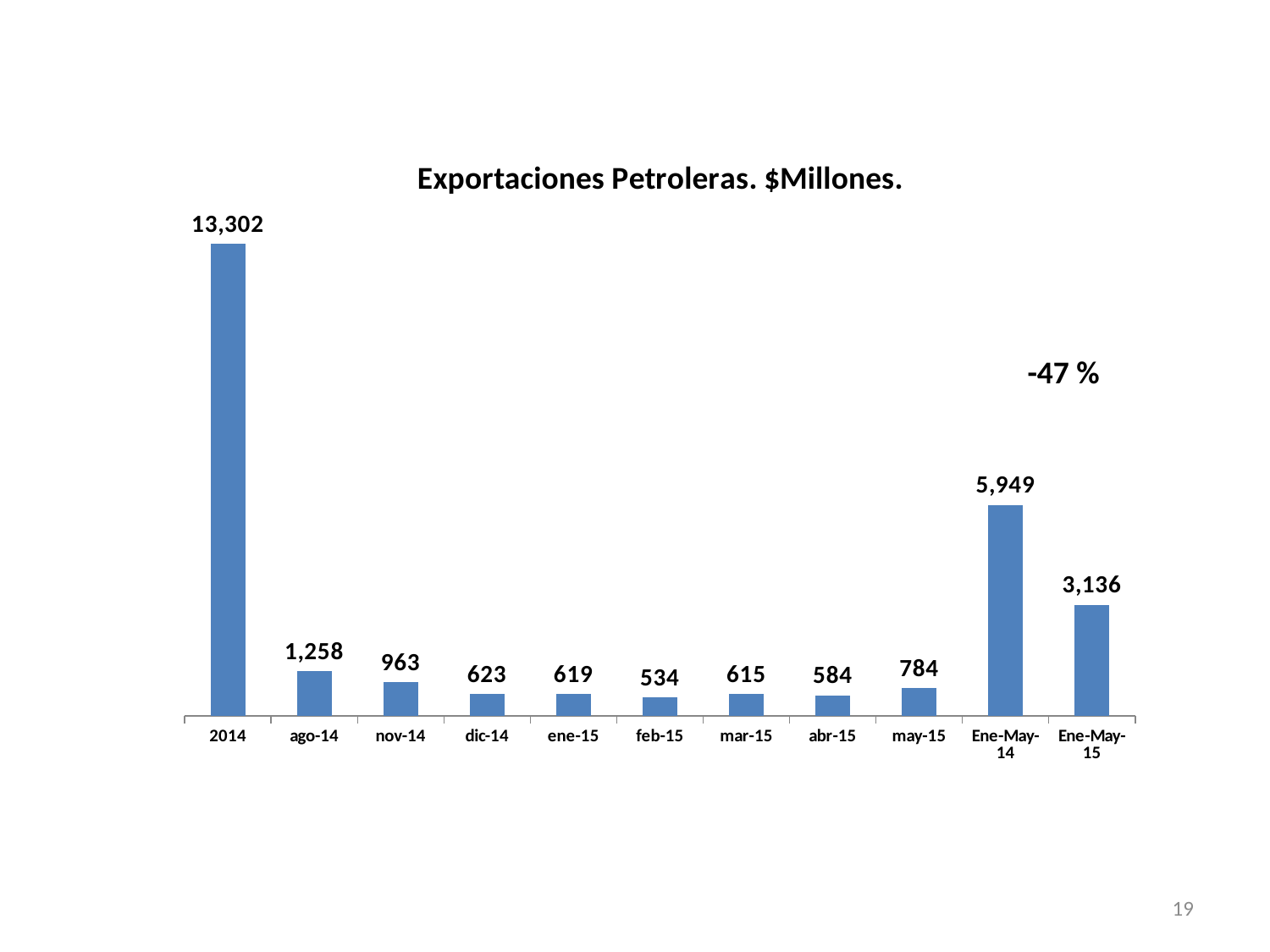
Which is larger, may-15 or abr-15? may-15 What is the value for Ene-May-15? 3,136 What is the difference between Ene-May-14 and Ene-May-15? 2,813 What is the value for feb-15? 534 What percentage change is annotated on the chart? -47 % What is the title of the chart? Exportaciones Petroleras. $Millones. What is the value for 2014? 13,302 What is the difference between ago-14 and nov-14? 295 How many bars are shown in the chart? 11 What kind of chart is this? bar chart Which category has the lowest value? feb-15 Which category has the highest value? 2014